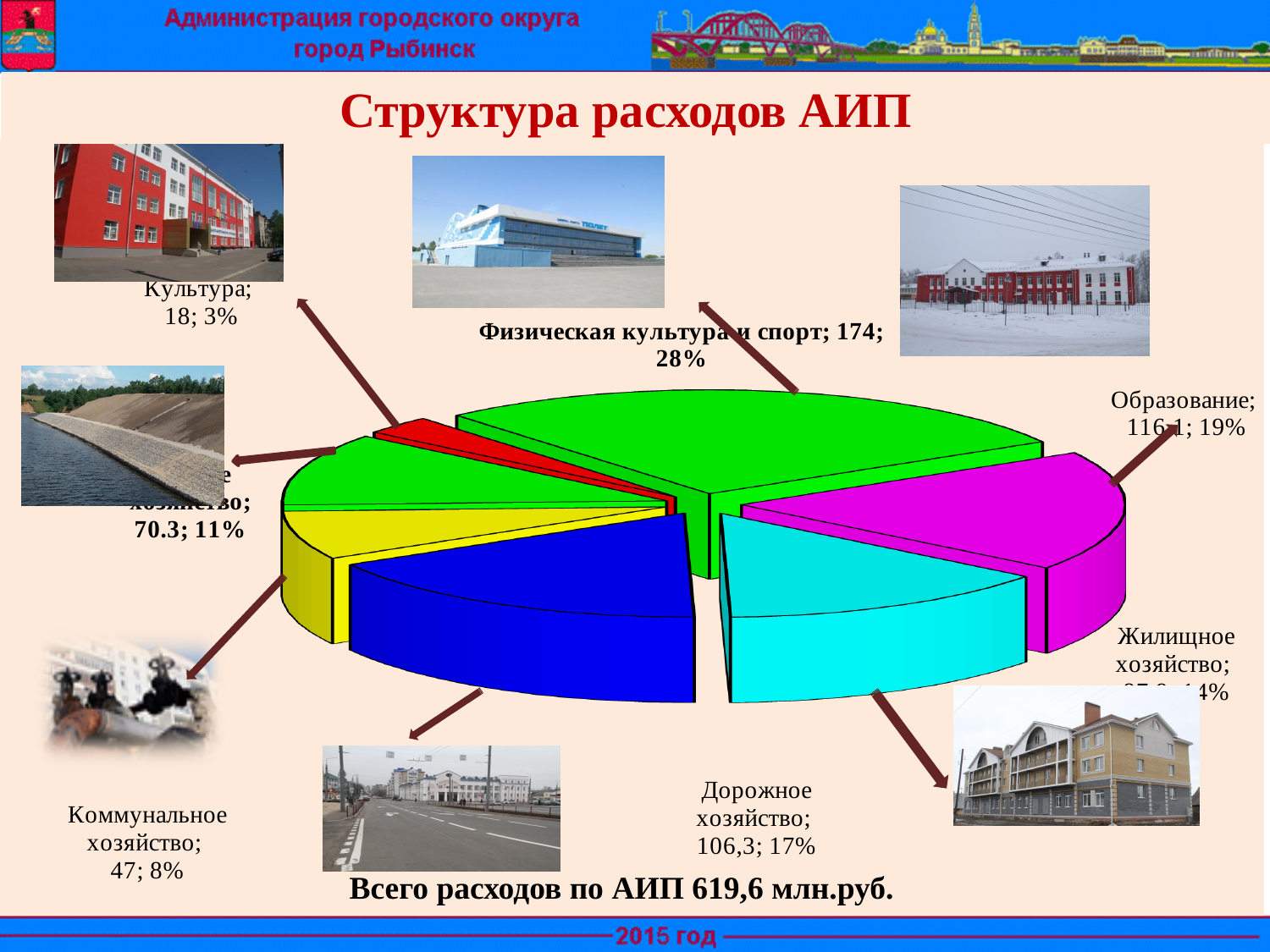
What value is shown for Дорожное хозяйство? 106,3 What is the difference between the values for Физическая культура и спорт and Культура? 156 What kind of chart is shown on the slide? Pie chart What share of the pie does Образование represent? 19% Which is larger, the value for Дорожное хозяйство or for Коммунальное хозяйство? Дорожное хозяйство Which category has the smallest share of the pie? Культура What value is shown for Физическая культура и спорт? 174 Which category has the largest share of the pie? Физическая культура и спорт What share of the pie does Культура represent? 3% What is the title of the chart? Структура расходов АИП What value is shown for Коммунальное хозяйство? 47 What value is shown for Культура? 18